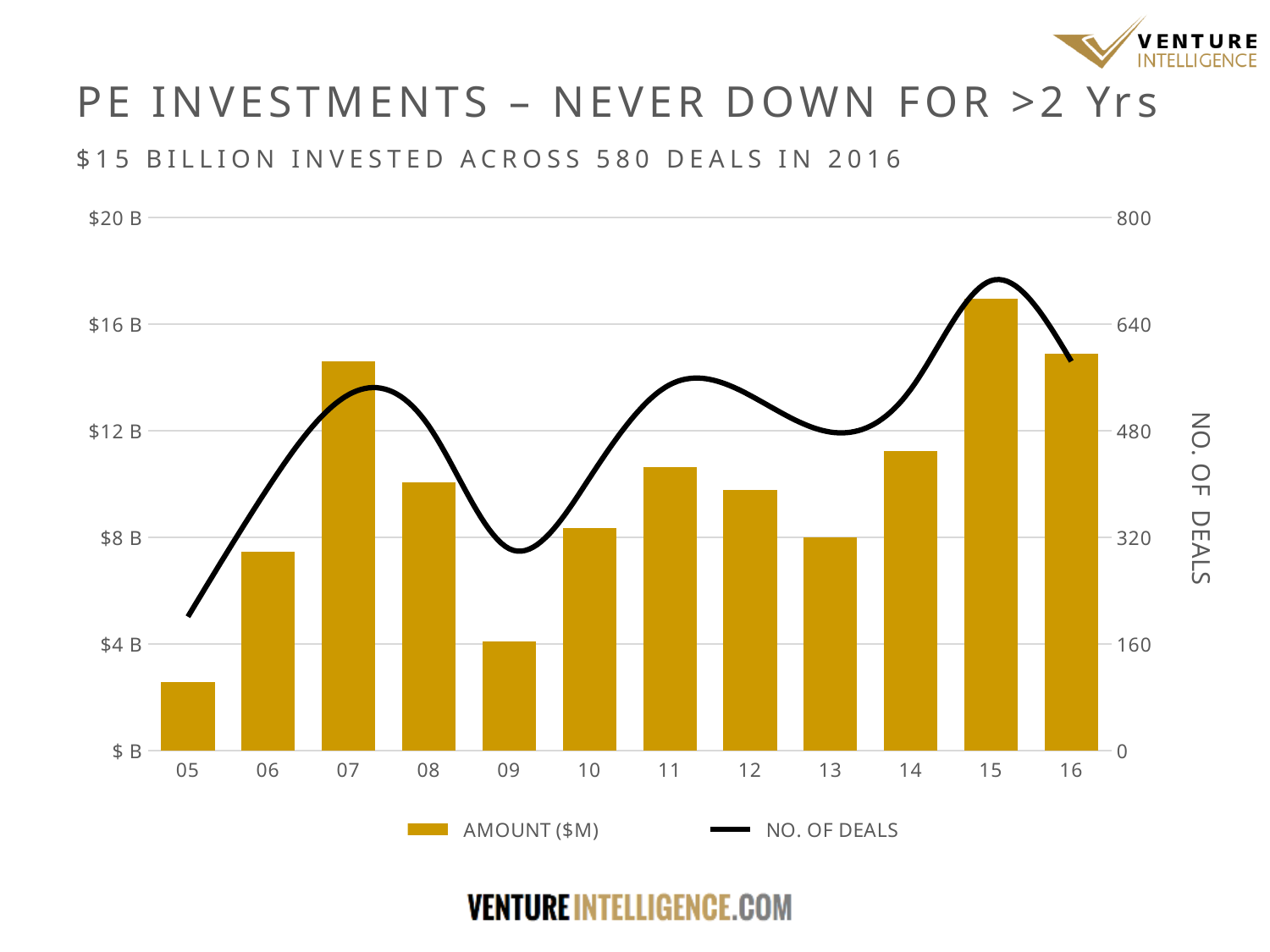
Which year has the larger AMOUNT bar, 07 or 08? 07 Is the AMOUNT bar for 05 greater or less than $4 B? less How many years are shown on the x axis of the chart? 12 Which year has the lowest bar for AMOUNT ($M)? 05 What is the title of the slide's chart? PE INVESTMENTS – NEVER DOWN FOR >2 Yrs Is the AMOUNT bar for 07 greater or less than $12 B? greater Which year has the highest bar for AMOUNT ($M)? 15 Is the NO. OF DEALS value for 15 greater or less than 640? greater What kind of chart is shown on the slide? A combined bar and line chart Do the AMOUNT bars rise or fall from 13 to 15? rise Which year has the highest NO. OF DEALS on the line? 15 How many series does the chart's legend list? 2